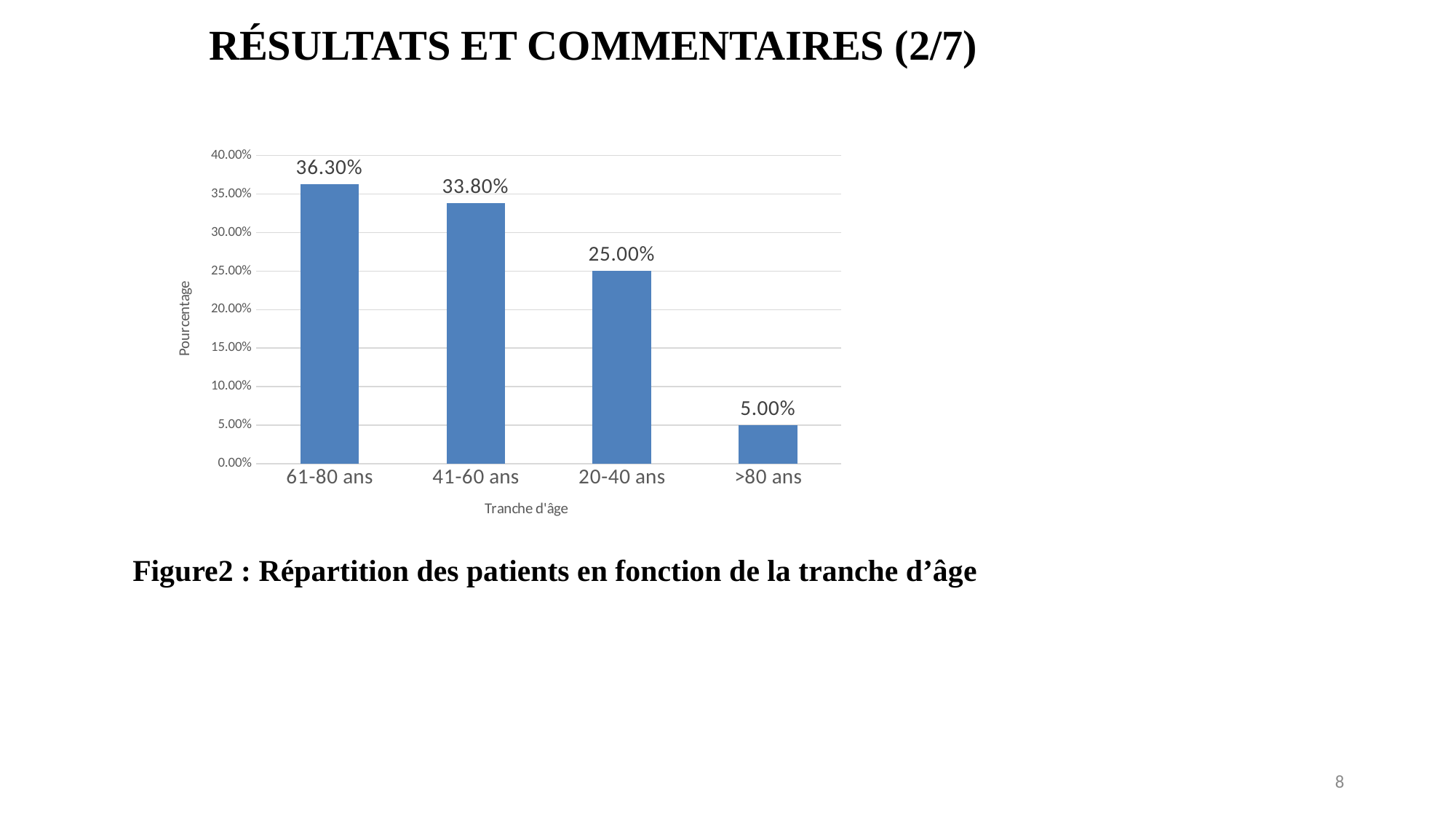
What is the value for the 61-80 ans age group? 36.30% Which age group has the lowest percentage? >80 ans What is the difference between the values for 61-80 ans and 41-60 ans? 2.50% Which age group has the highest percentage? 61-80 ans Which is larger, the value for 41-60 ans or the value for 20-40 ans? 41-60 ans What is the value for the >80 ans age group? 5.00% What is the value for the 20-40 ans age group? 25.00% How many age groups are shown on the chart? 4 What kind of chart is shown on the slide? Bar chart What is the label of the x axis? Tranche d'âge What is the difference between the values for 20-40 ans and >80 ans? 20.00% What is the value for the 41-60 ans age group? 33.80%